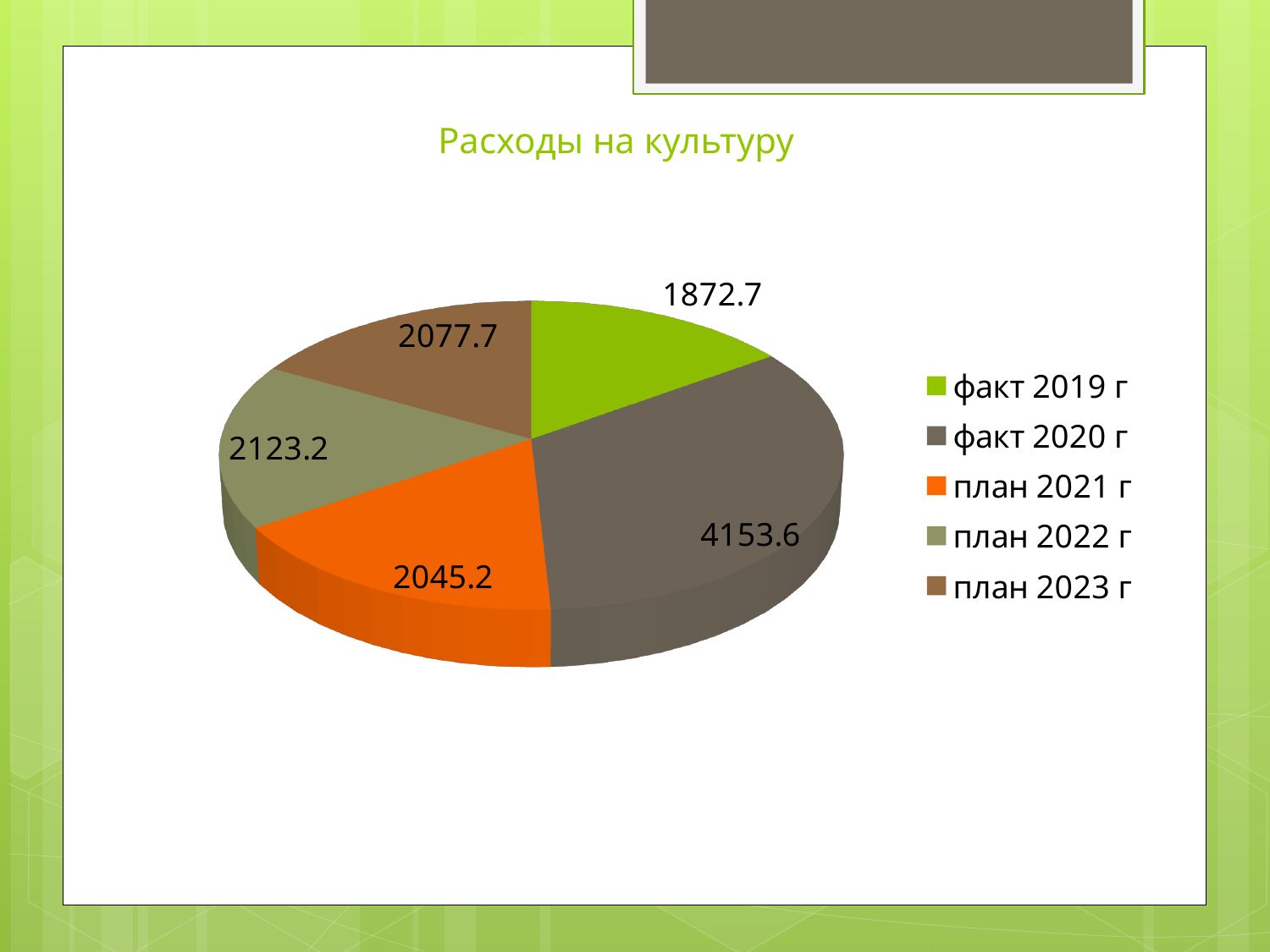
What is the value for план 2022 г? 2123.2 What is the difference between факт 2020 г and факт 2019 г? 2280.9 What type of chart is shown on the slide? pie chart What is the value for факт 2020 г? 4153.6 Which category has the smallest slice? факт 2019 г What is the title of the chart? Расходы на культуру Which is larger, план 2022 г or план 2021 г? план 2022 г Which category has the largest slice? факт 2020 г What colour is the slice for план 2021 г? orange How many entries does the legend list? 5 What is the value for факт 2019 г? 1872.7 How many slices does the pie chart have? 5